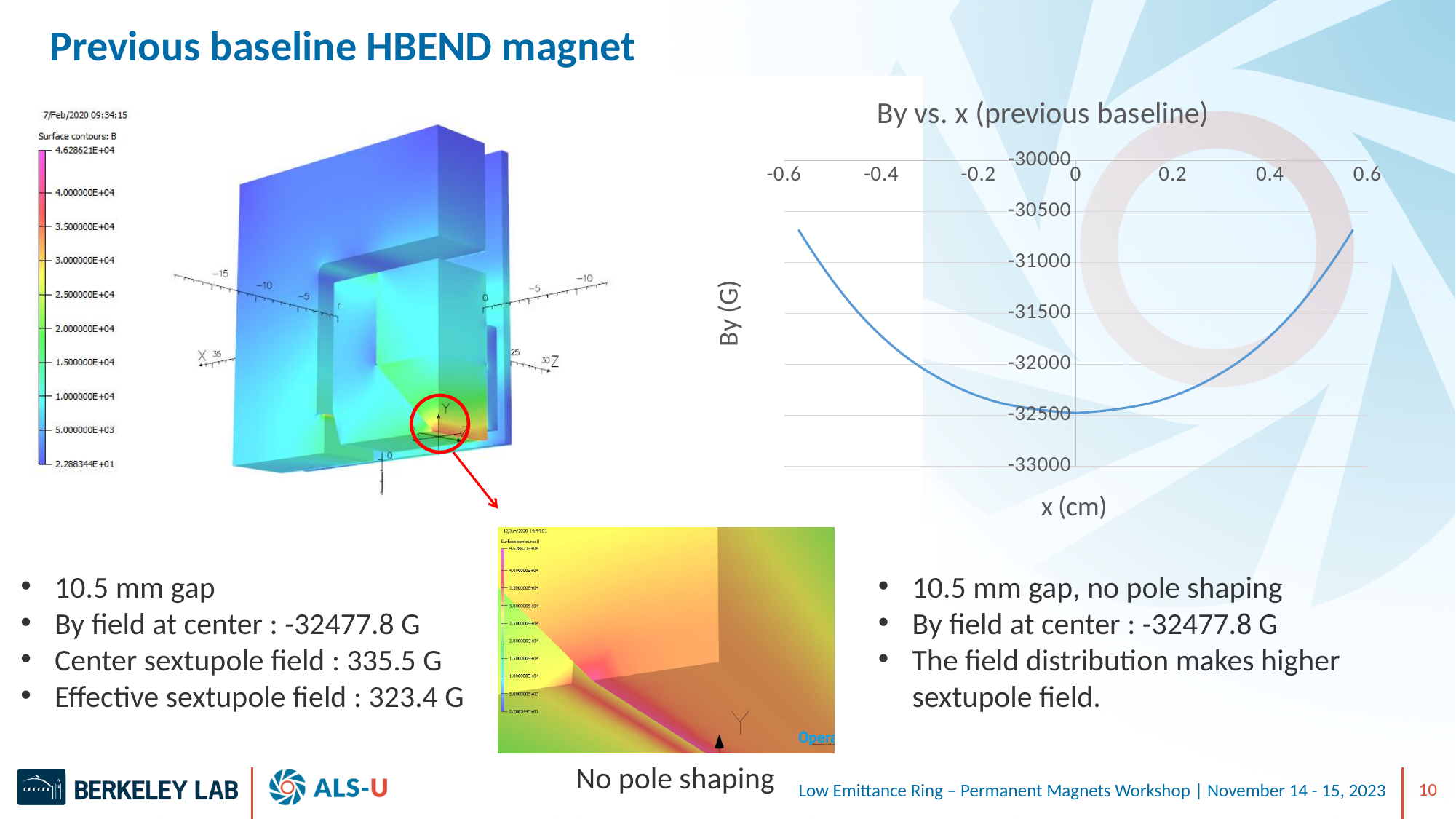
In the 'By vs. x (previous baseline)' chart, is the value of By at x = 0.2 greater or less than -32000? less In the 'By vs. x (previous baseline)' chart, does By rise or fall as x goes from 0 to 0.6? rise What is the title of the chart on the right of the slide? By vs. x (previous baseline) In the 'By vs. x (previous baseline)' chart, does By rise or fall as x goes from -0.6 to 0? fall How many lines are plotted in the 'By vs. x (previous baseline)' chart? 1 What is the label of the vertical axis of the 'By vs. x (previous baseline)' chart? By (G) In the 'By vs. x (previous baseline)' chart, is the value of By at x = 0 greater or less than -32000? less In the 'By vs. x (previous baseline)' chart, which is larger: By at x = 0 or By at x = 0.6? By at x = 0.6 In the 'By vs. x (previous baseline)' chart, is the value of By at x = -0.6 greater or less than -31000? greater What kind of chart is 'By vs. x (previous baseline)'? line chart